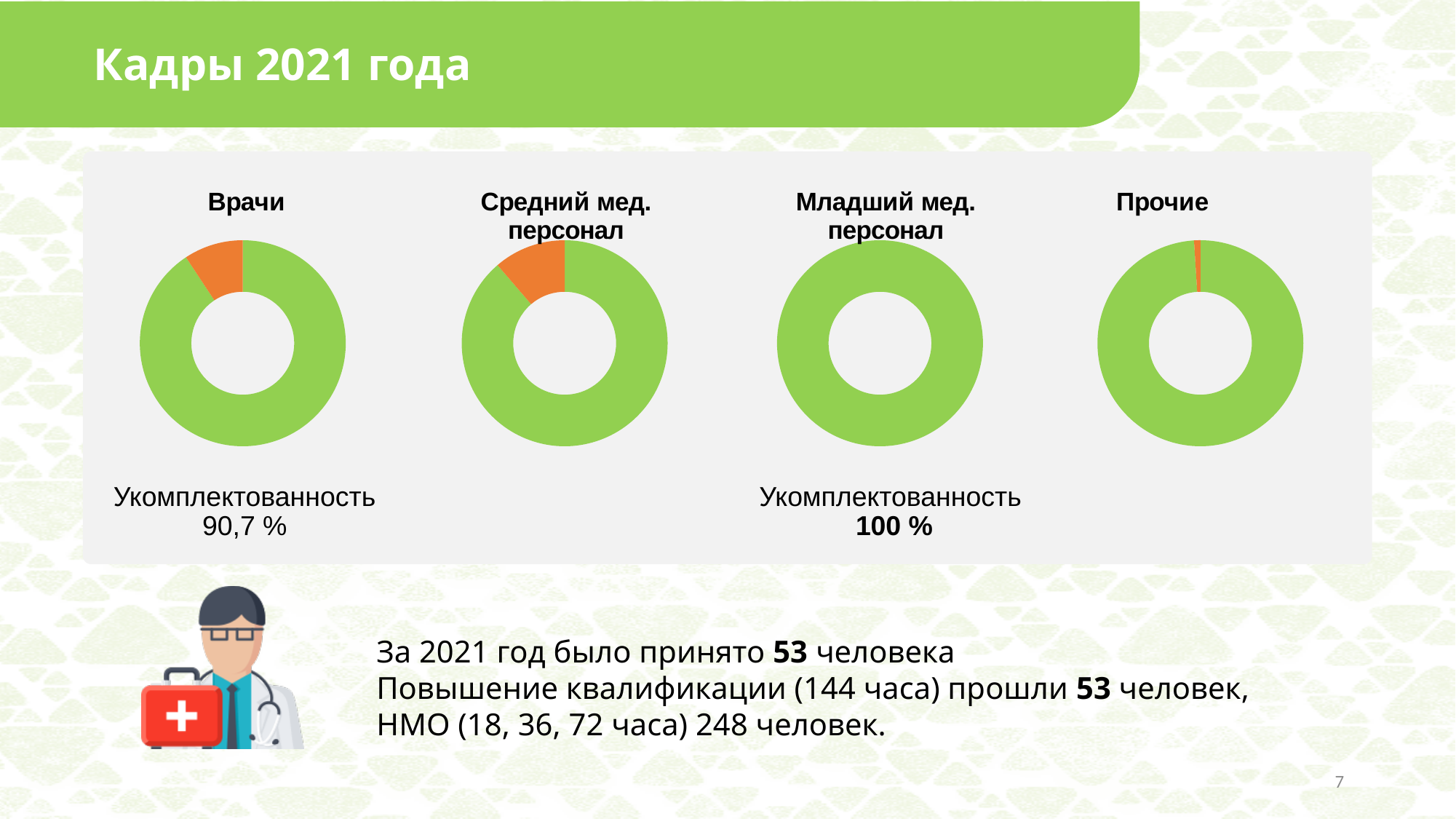
What kind of charts are shown on the slide? Donut (pie) charts What staffing level (Укомплектованность) is printed under the Младший мед. персонал donut chart? 100 % In the Врачи donut chart, which slice is larger, the green one or the orange one? Green Is the staffing level printed under the Врачи donut chart greater or less than 100 %? less In the Средний мед. персонал donut chart, which slice is larger, the green one or the orange one? Green How many donut charts are shown on the slide? 4 Which donut chart has no orange slice at all? Младший мед. персонал Which donut chart has a larger orange slice, Прочие or Средний мед. персонал? Средний мед. персонал How many colours are used for the slices in the Врачи donut chart? 2 What is the title of the rightmost donut chart? Прочие What staffing level (Укомплектованность) is printed under the Врачи donut chart? 90,7 % What is the title of the leftmost donut chart? Врачи